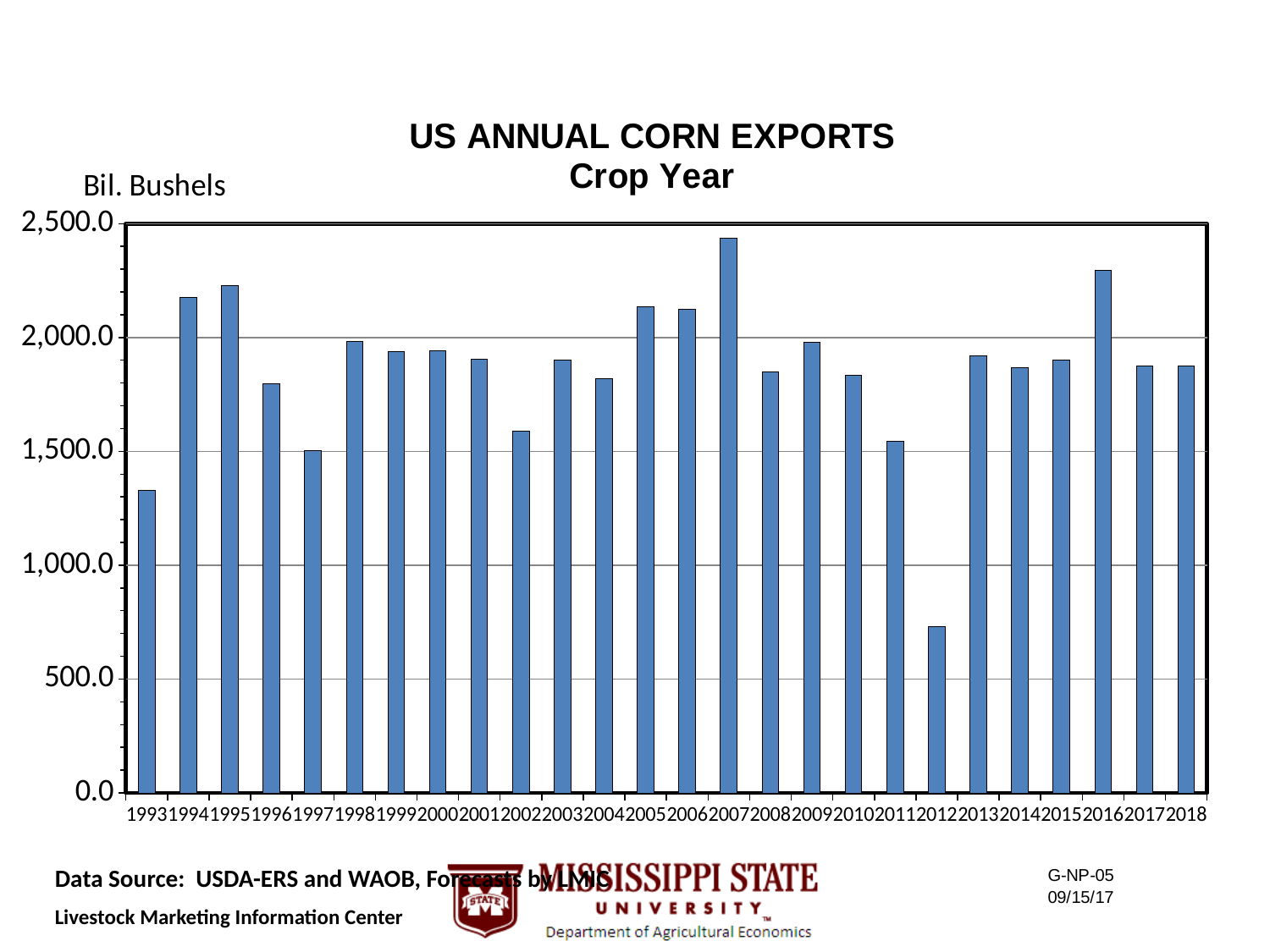
Which crop year has the lowest US annual corn exports? 2012 How many crop years are plotted on the chart? 26 Is the value for 1993 greater or less than 1,500.0? less Is the value for 2016 greater or less than 2,000.0? greater Is the value for 2007 greater or less than 2,000.0? greater Which crop year has the larger value, 1996 or 1997? 1996 Which crop year has the larger value, 2007 or 2016? 2007 What kind of chart is shown on the slide? bar chart Which crop year has the highest US annual corn exports? 2007 What unit is shown for the vertical axis of the chart? Bil. Bushels